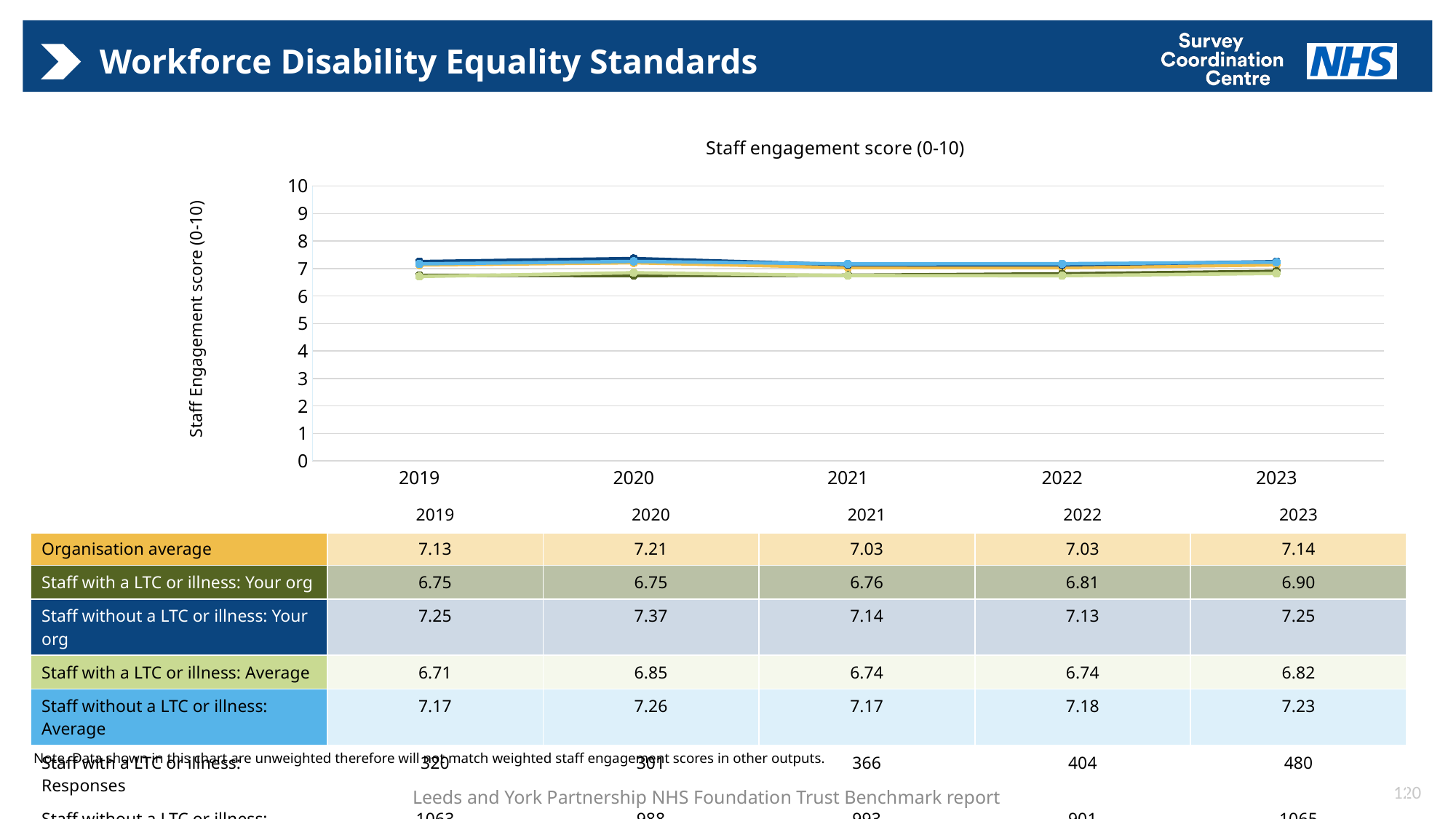
In which year is the score for Staff with a LTC or illness: Average lowest? 2019 Is the 2019 score for Staff with a LTC or illness: Your org greater or less than 7? less What kind of chart is shown on the slide? line chart In 2023, what is the difference between the scores for Staff without a LTC or illness: Your org and Staff with a LTC or illness: Your org? 0.35 How many years are shown on the x axis of the chart? 5 What is the title of the chart? Staff engagement score (0-10) What is the staff engagement score for Staff without a LTC or illness: Your org in 2020? 7.37 In which year is the score for Staff without a LTC or illness: Your org highest? 2020 How many data series are plotted in the chart? 5 What is the Organisation average staff engagement score in 2020? 7.21 What is the staff engagement score for Staff with a LTC or illness: Your org in 2023? 6.90 In 2022, which is higher: the Organisation average or Staff without a LTC or illness: Average? Staff without a LTC or illness: Average